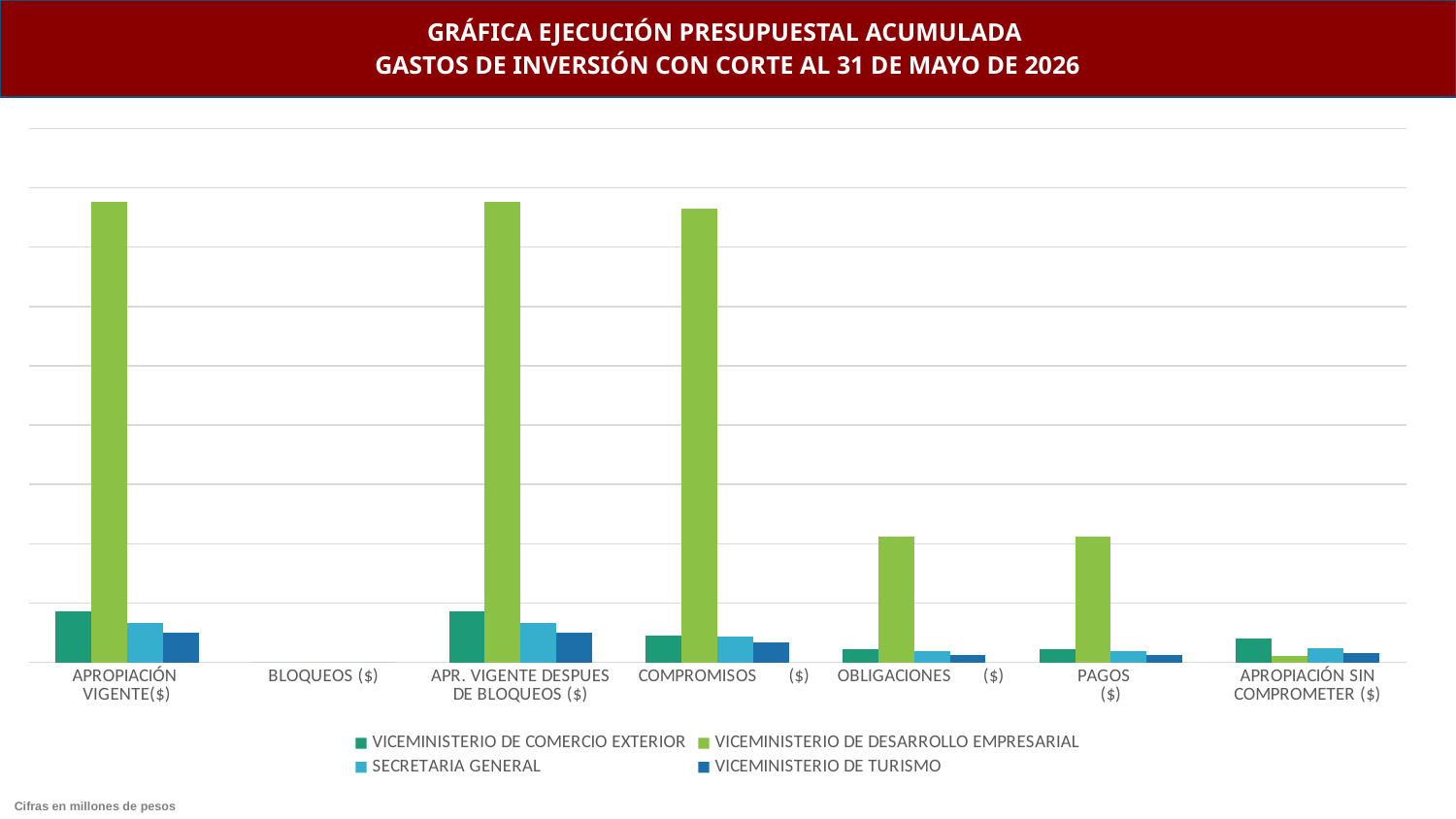
Does the value for VICEMINISTERIO DE DESARROLLO EMPRESARIAL rise or fall from COMPROMISOS ($) to OBLIGACIONES ($)? Fall Which category shows no visible bars for any series? BLOQUEOS ($) According to the note at the bottom of the slide, in what units are the figures expressed? Millones de pesos Which series has the highest value in the PAGOS ($) category? VICEMINISTERIO DE DESARROLLO EMPRESARIAL What kind of chart is shown on the slide? Bar chart What is the cut-off date stated in the chart title? 31 de mayo de 2026 How many series does the legend list? 4 In the COMPROMISOS ($) category, which is larger: SECRETARIA GENERAL or VICEMINISTERIO DE TURISMO? SECRETARIA GENERAL Which series has the highest value in the APROPIACIÓN VIGENTE($) category? VICEMINISTERIO DE DESARROLLO EMPRESARIAL How many categories are shown along the x axis? 7 Which series has the lowest value in the APROPIACIÓN VIGENTE($) category? VICEMINISTERIO DE TURISMO In the APROPIACIÓN SIN COMPROMETER ($) category, which is larger: VICEMINISTERIO DE COMERCIO EXTERIOR or VICEMINISTERIO DE DESARROLLO EMPRESARIAL? VICEMINISTERIO DE COMERCIO EXTERIOR